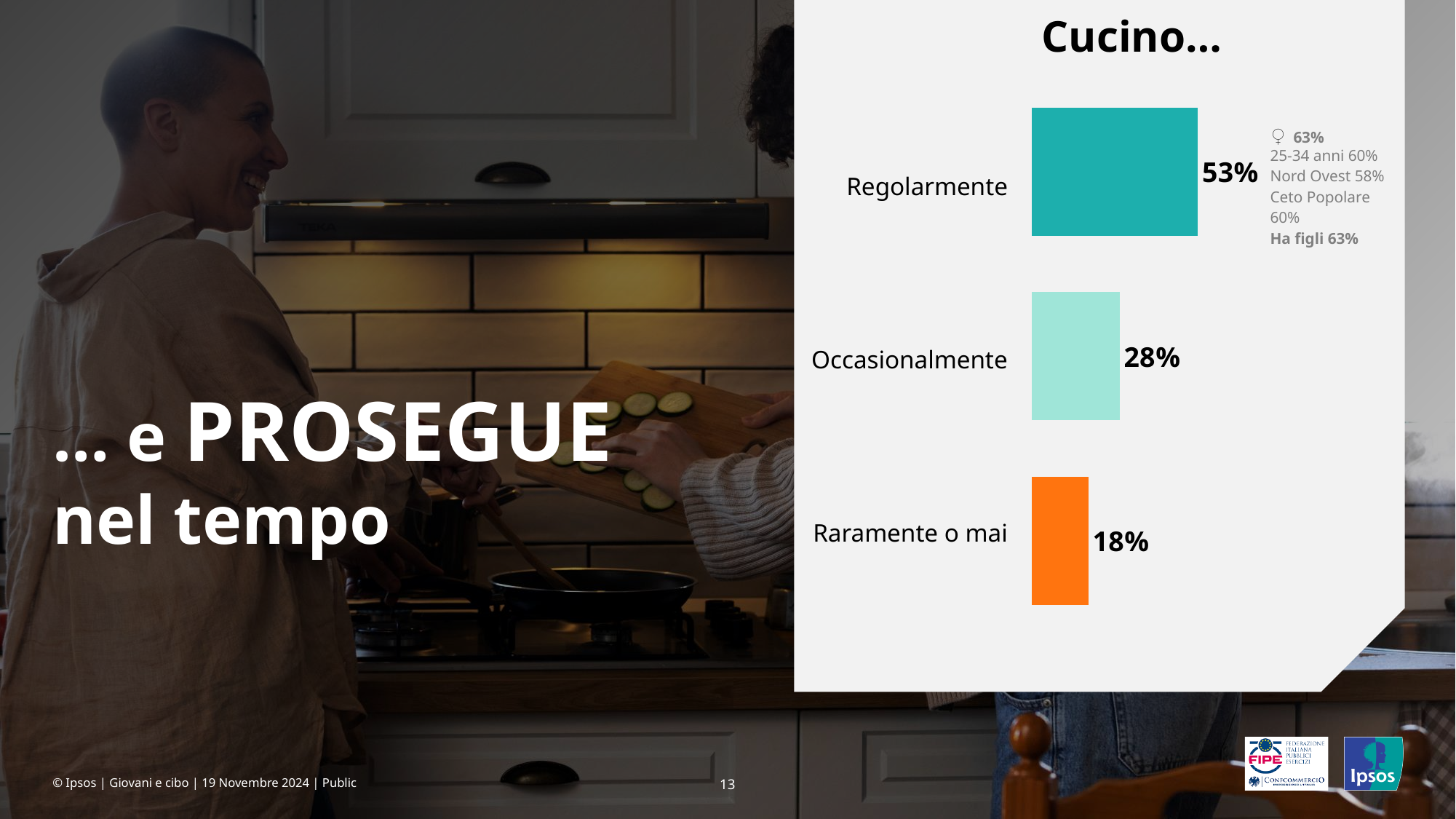
Which is larger, the value for Occasionalmente or the value for Raramente o mai? Occasionalmente What is the value for Occasionalmente? 28% What is the difference between the values for Regolarmente and Occasionalmente? 25% What is the value for Raramente o mai? 18% Which category has the highest value? Regolarmente What is the difference between the values for Occasionalmente and Raramente o mai? 10% What is the title of the chart? Cucino... What kind of chart is shown on the slide? Bar chart How many categories does the chart show? 3 What colour is the bar for Raramente o mai? Orange What is the value for Regolarmente? 53% Which category has the lowest value? Raramente o mai